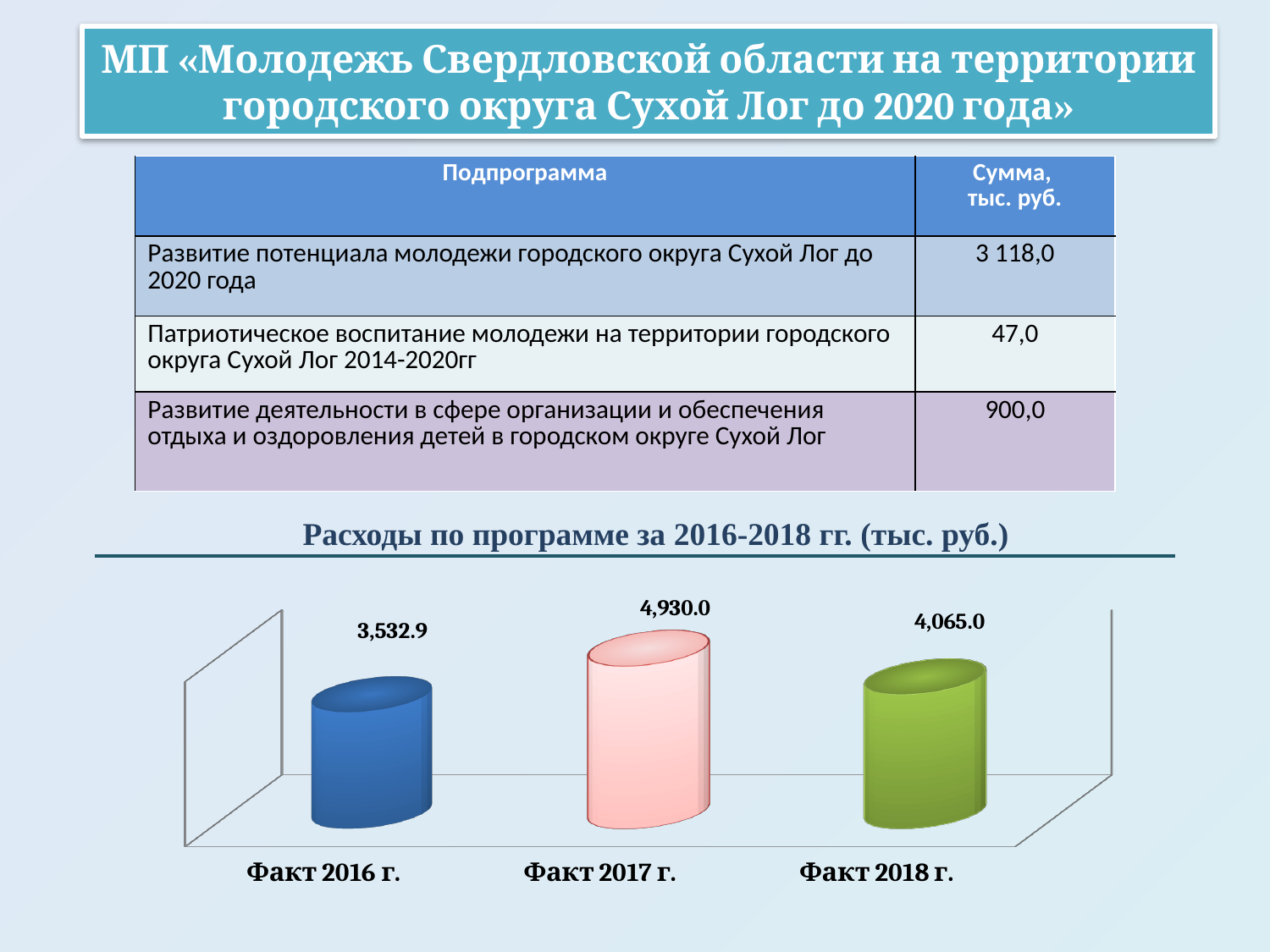
What is the difference between the values for Факт 2017 г. and Факт 2018 г.? 865.0 How many categories are shown in the chart? 3 Which category has the lowest value? Факт 2016 г. Which is larger, the value for Факт 2018 г. or Факт 2016 г.? Факт 2018 г. What is the value for Факт 2017 г.? 4,930.0 What kind of chart is shown on the slide? Bar chart Do the values rise or fall from Факт 2017 г. to Факт 2018 г.? Fall What is the value for Факт 2018 г.? 4,065.0 What is the title of the chart? Расходы по программе за 2016-2018 гг. (тыс. руб.) What is the difference between the values for Факт 2017 г. and Факт 2016 г.? 1,397.1 What is the value for Факт 2016 г.? 3,532.9 Which category has the highest value? Факт 2017 г.